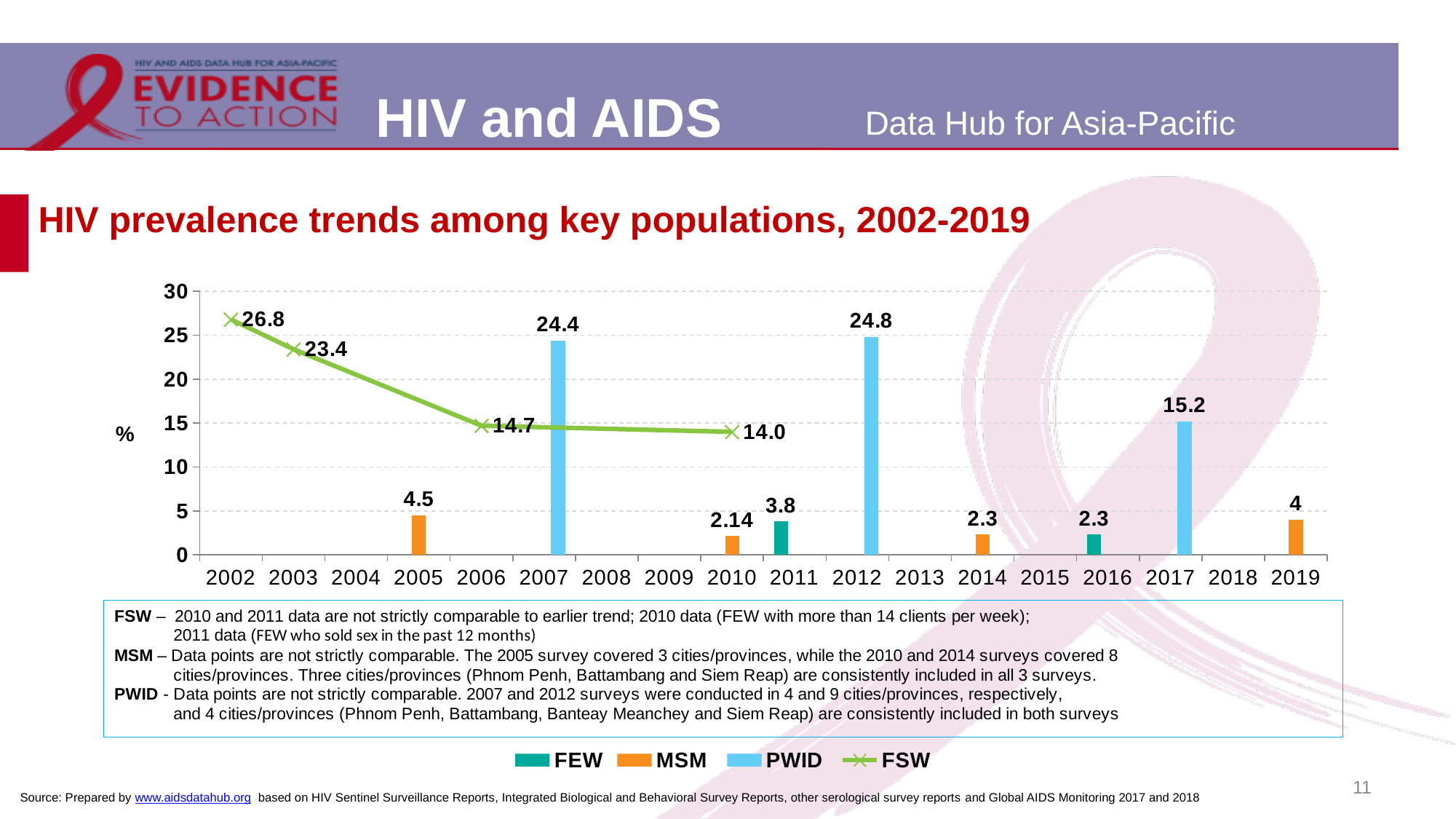
In which year is the FSW value lowest? 2010 How many series does the legend list? 4 In which year is the PWID value highest? 2012 Which series is plotted as a line rather than bars? FSW Does the FSW line rise or fall from 2002 to 2010? fall What is the difference between the PWID values in 2012 and 2017? 9.6 What is the MSM value in 2010? 2.14 What is the FSW value in 2002? 26.8 What is the FEW value in 2011? 3.8 Which is larger, the MSM value in 2005 or in 2019? 2005 What is the difference between the FSW values in 2002 and 2003? 3.4 What is the HIV prevalence value for PWID in 2007? 24.4